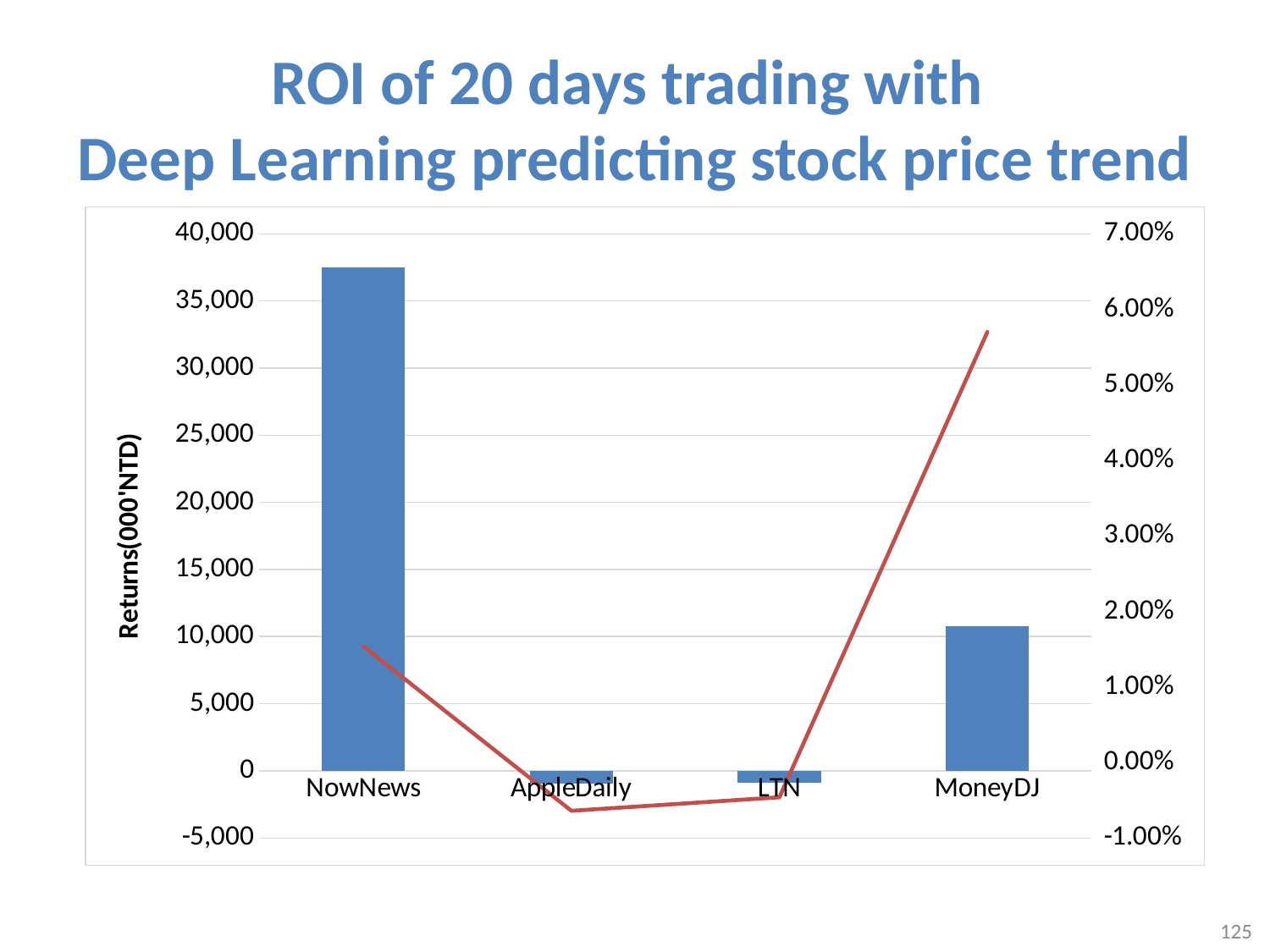
Is the returns bar for MoneyDJ greater or less than 10,000? greater What is the title of the left vertical axis? Returns(000'NTD) Which has the higher red line value, NowNews or MoneyDJ? MoneyDJ What type of chart is shown on the slide? A bar chart combined with a line How many categories are shown on the x axis? 4 Which has the larger returns bar, NowNews or MoneyDJ? NowNews Which category has the highest bar for returns? NowNews Is the red line value for MoneyDJ greater or less than 5.00%? greater Is the returns bar for NowNews greater or less than 35,000? greater Which category has the highest point on the red line? MoneyDJ What is the highest tick label on the right vertical axis? 7.00%